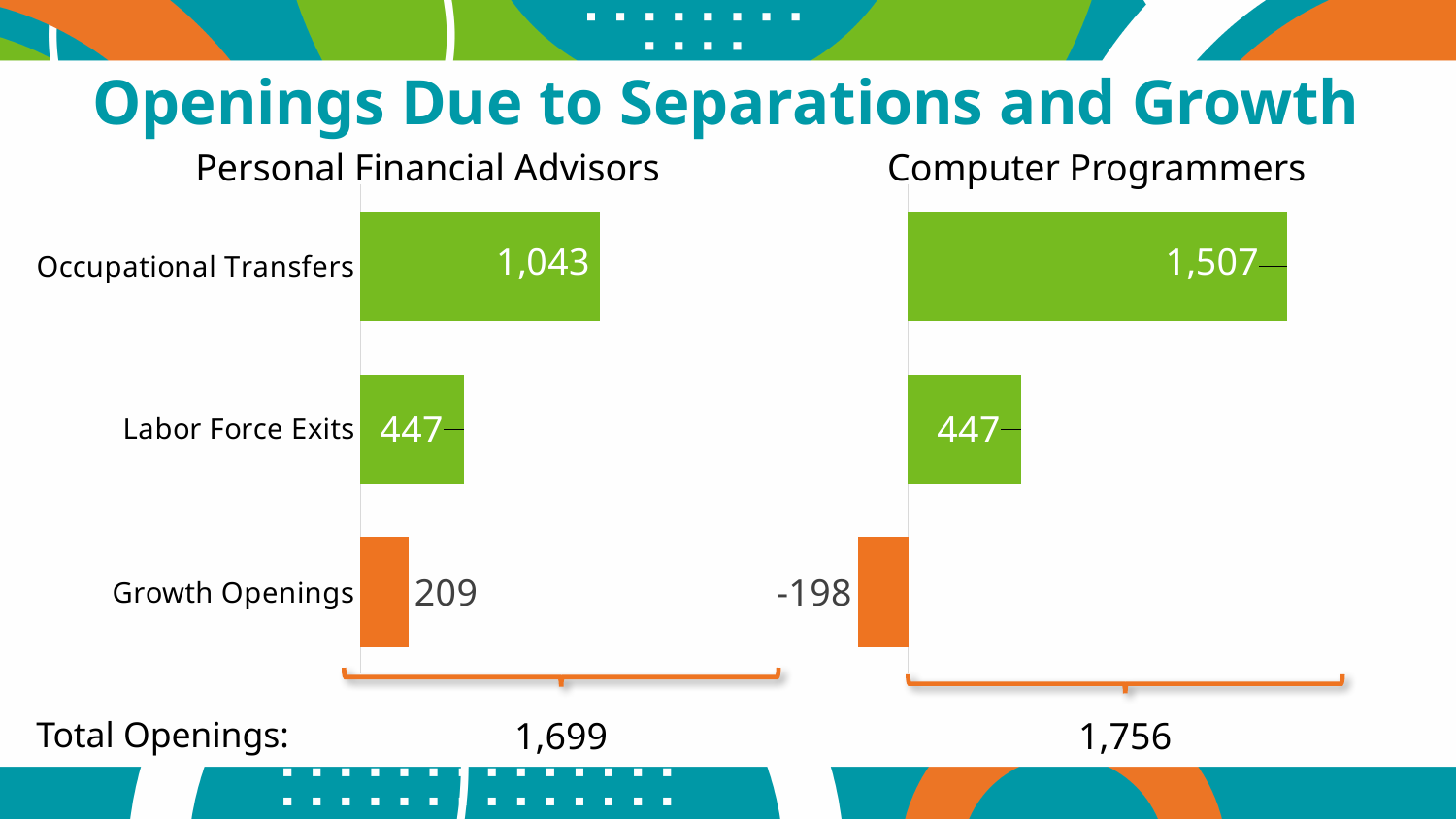
In the Personal Financial Advisors chart, what is the value for Growth Openings? 209 In the Computer Programmers chart, which category has the lowest value? Growth Openings In the Computer Programmers chart, what is the value for Occupational Transfers? 1,507 What colour are the Growth Openings bars in both charts? Orange In the Computer Programmers chart, what is the value for Growth Openings? -198 What kind of chart is used for Computer Programmers? Bar chart What is the difference between Occupational Transfers for Computer Programmers and Occupational Transfers for Personal Financial Advisors? 464 In the Personal Financial Advisors chart, which category has the highest value? Occupational Transfers Which is larger: Labor Force Exits for Personal Financial Advisors or Labor Force Exits for Computer Programmers? They are equal (447) In the Personal Financial Advisors chart, what is the value for Occupational Transfers? 1,043 How many categories are shown in the Personal Financial Advisors chart? 3 What is the Total Openings figure shown for Computer Programmers? 1,756